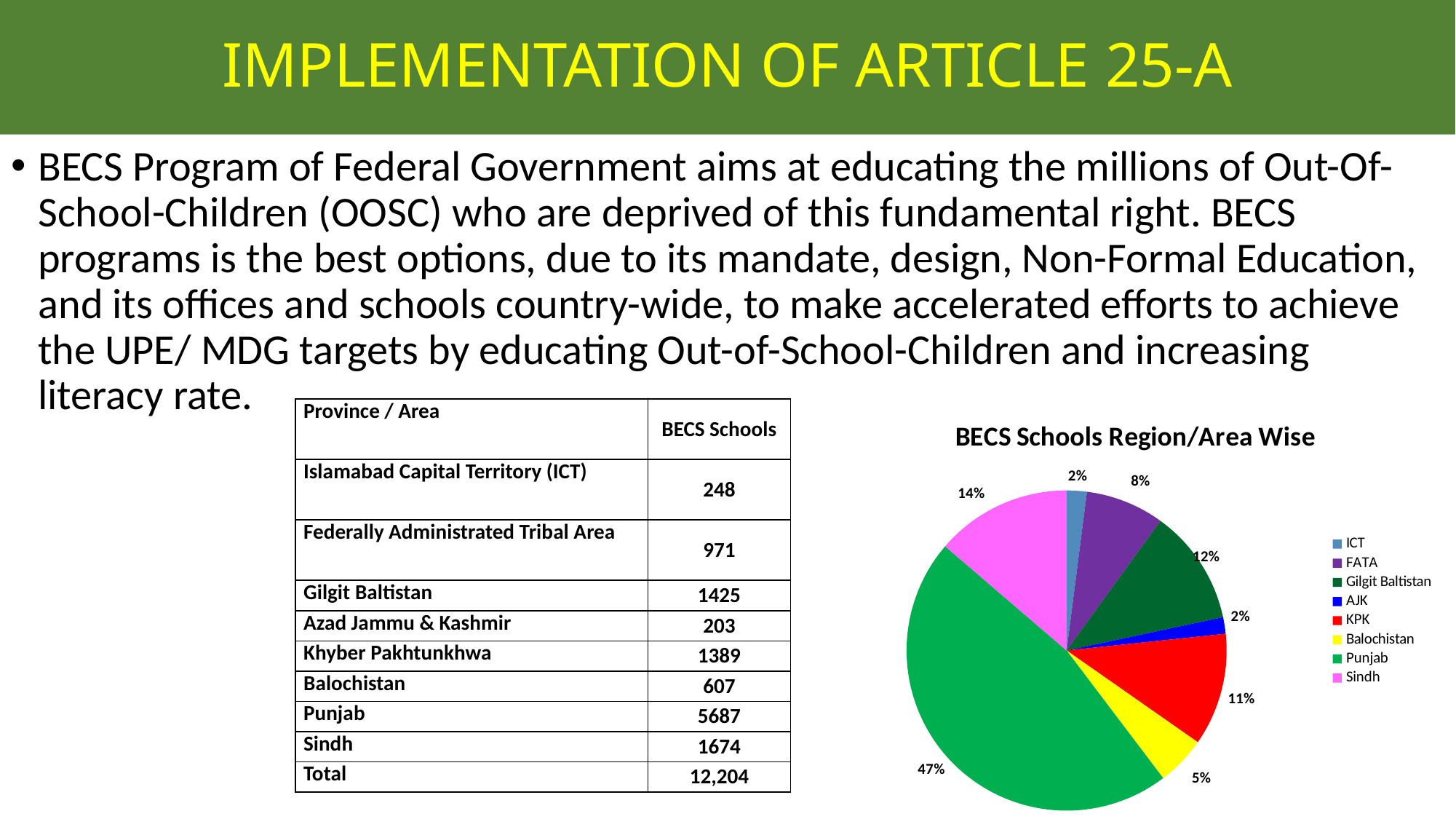
Which region has the largest slice in the pie chart? Punjab What is the difference in percentage points between the Punjab slice and the Sindh slice in the pie chart? 33 What type of chart is shown on the slide? Pie chart How many regions does the legend of the pie chart list? 8 What share of the pie chart does Punjab account for? 47% What is the title of the pie chart? BECS Schools Region/Area Wise What share of the pie chart does KPK account for? 11% What share of the pie chart does Balochistan account for? 5% Which slice is larger in the pie chart, FATA or Sindh? Sindh What colour is the Punjab slice in the pie chart? Green